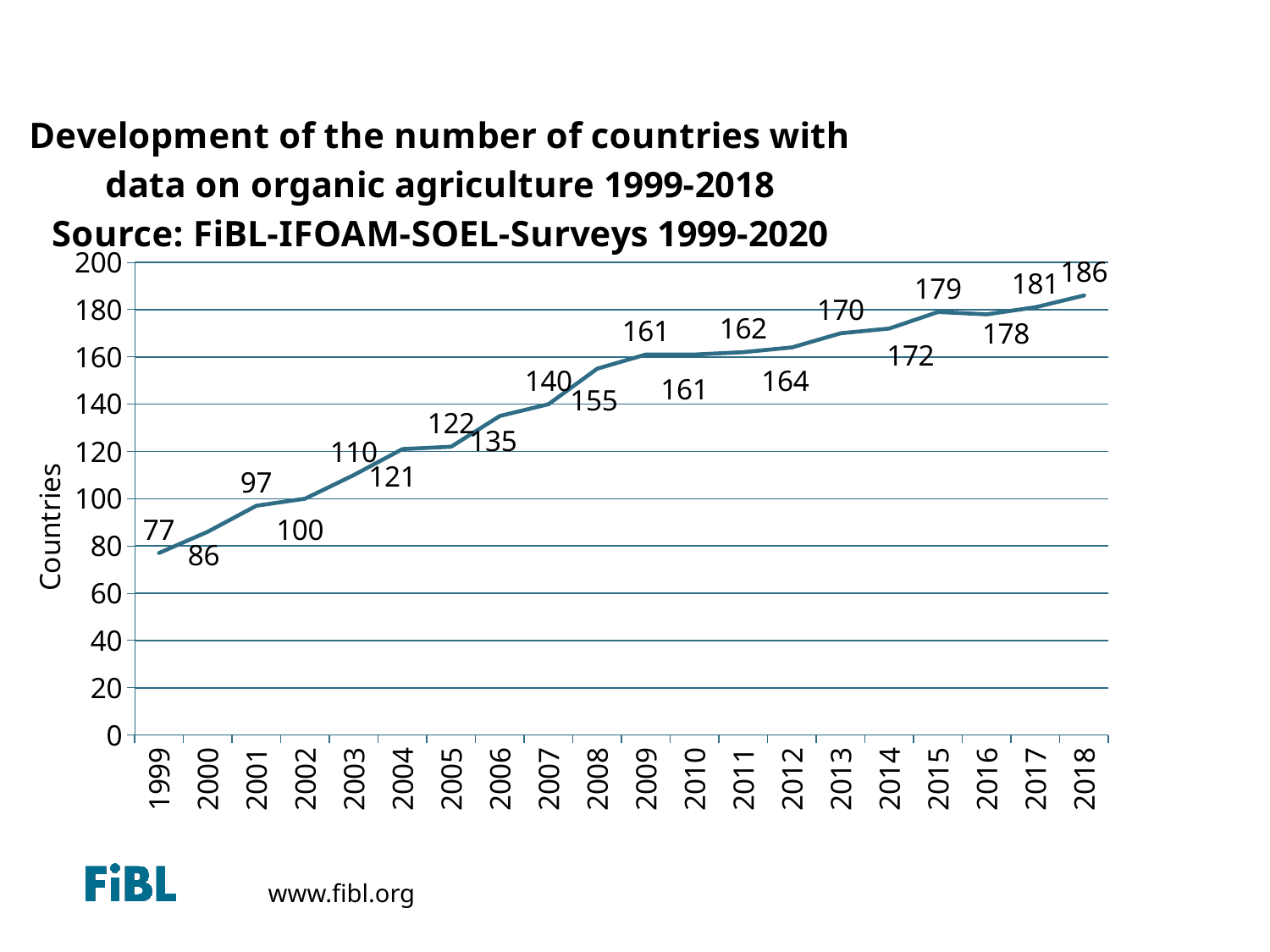
What is the difference in the number of countries between 2015 and 2016? 1 Which year has the highest number of countries? 2018 Which year has more countries, 2013 or 2014? 2014 Does the number of countries generally rise or fall from 1999 to 2018? Rise How many years are shown on the x axis? 20 What is the number of countries with data on organic agriculture in 2004? 121 What is the number of countries with data on organic agriculture in 2018? 186 What is the number of countries with data on organic agriculture in 1999? 77 Which year has the lowest number of countries? 1999 What is the number of countries with data on organic agriculture in 2009? 161 By how much did the number of countries increase from 1999 to 2018? 109 What kind of chart is shown on the slide? Line chart